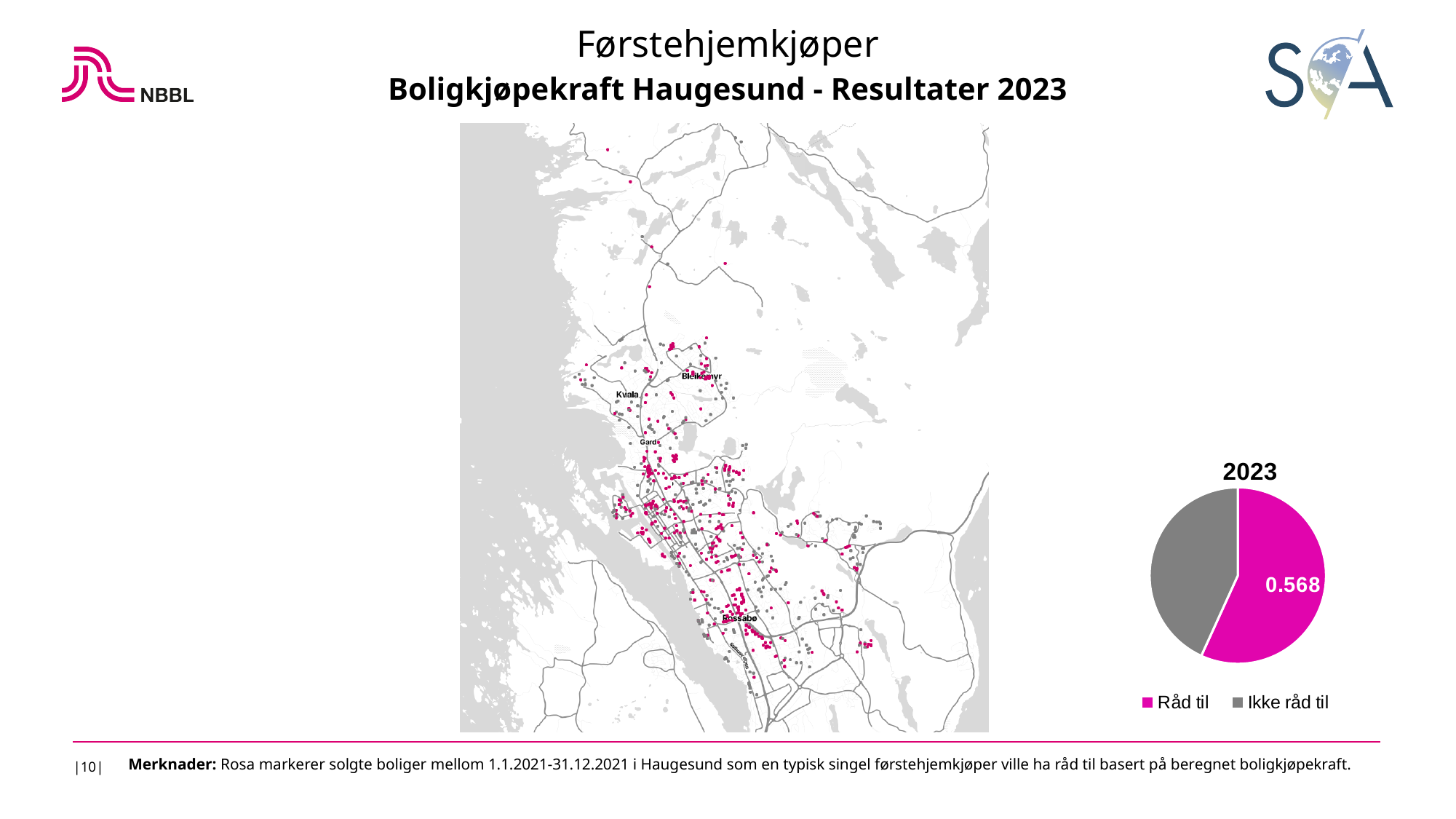
In the 2023 pie chart, which slice is larger: Råd til or Ikke råd til? Råd til How many slices does the 2023 pie chart have? 2 What kind of chart is shown on the right side of the slide under the heading 2023? Pie chart How many entries does the legend of the 2023 pie chart list? 2 In the 2023 pie chart, what colour is the Ikke råd til slice? Grey In the 2023 pie chart, which category has the largest slice? Råd til What is the title shown above the pie chart? 2023 In the 2023 pie chart, what value is printed on the Råd til slice? 0.568 In the 2023 pie chart, which category has the smallest slice? Ikke råd til